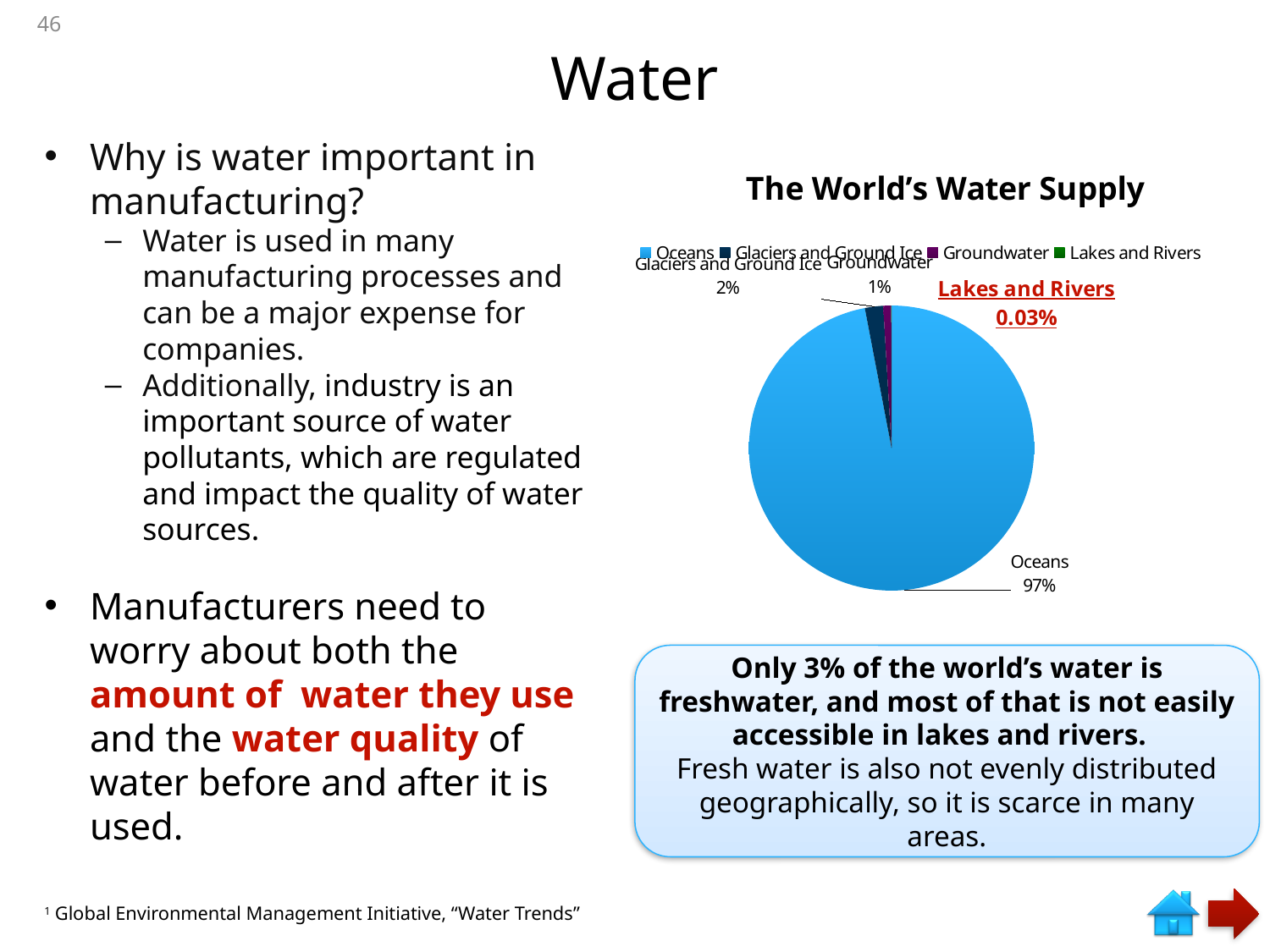
What percentage of the world's water supply is in Oceans according to the pie chart? 97% Which category has the smallest share of the pie chart? Lakes and Rivers What is the title of the chart? The World's Water Supply How many categories does the legend of the pie chart list? 4 Which category's label is shown in red, underlined text on the pie chart? Lakes and Rivers What type of chart is shown on the slide? pie chart What percentage of the world's water supply is in Lakes and Rivers according to the pie chart? 0.03% What is the difference in percentage points between the Oceans share and the Glaciers and Ground Ice share? 95 Which is larger in the pie chart, Glaciers and Ground Ice or Groundwater? Glaciers and Ground Ice What percentage of the world's water supply is Groundwater according to the pie chart? 1% What percentage of the world's water supply is in Glaciers and Ground Ice according to the pie chart? 2% Which category has the largest share of the pie chart? Oceans